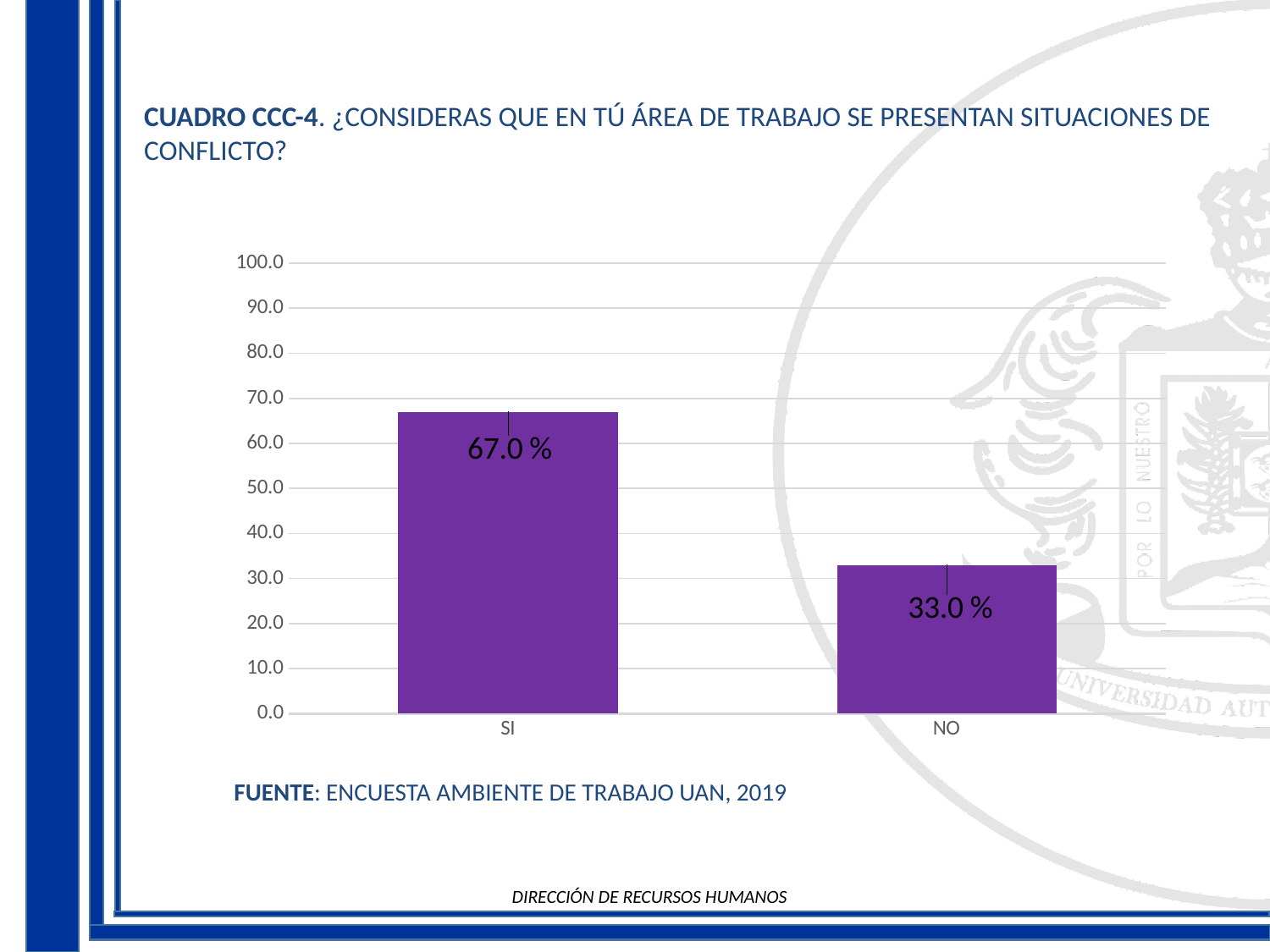
Is the value for SI greater or less than 60.0? greater Which category has the highest value? SI Is the value for NO greater or less than 40.0? less What is the value for SI? 67.0 % Which category has the lowest value? NO What is the maximum value shown on the y axis? 100.0 What kind of chart is shown on the slide? bar chart What is the value for NO? 33.0 % Which is larger, the value for SI or the value for NO? SI What is the difference between the values for SI and NO? 34.0 % How many categories are shown on the x axis? 2 What colour are the bars in the chart? purple